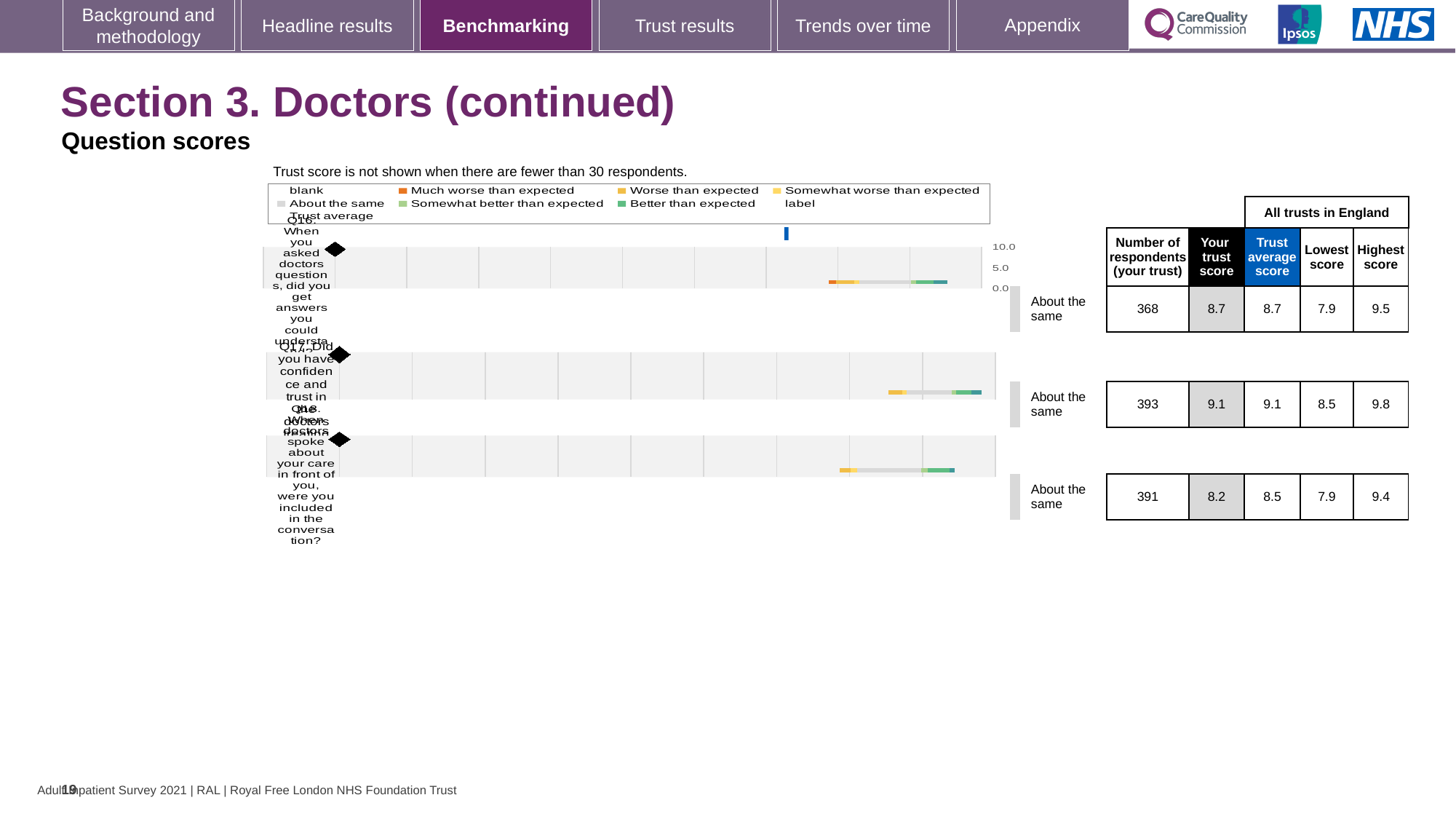
What kind of chart is used to show the question scores on this slide? bar chart What is the difference between the highest score and the lowest score for Q18? 1.5 What is the difference between the trust average score and the trust score for Q18? 0.3 Which question has the highest trust score on this slide? Q17 What benchmark category is shown for Q18 on this slide? About the same What is the number of respondents (your trust) for Q17? 393 How many questions are plotted in the chart on this slide? 3 Which has the larger trust score, Q16 or Q18? Q16 Which question has the lowest trust score on this slide? Q18 What is the trust score for Q16 (when you asked doctors questions, did you get answers you could understand)? 8.7 What is the highest score across all trusts in England for Q17? 9.8 What is the trust average score for Q18? 8.5